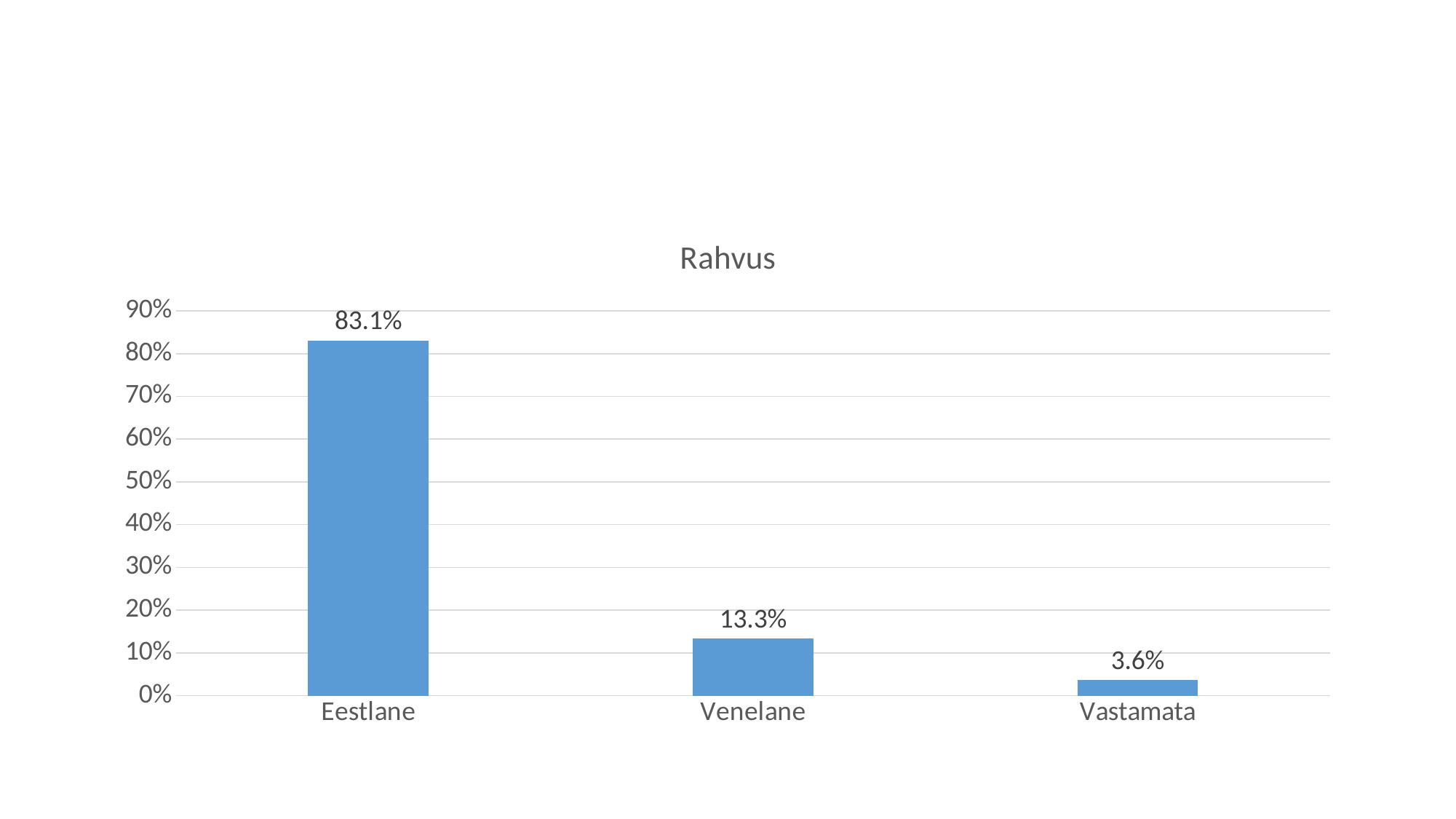
What is the value for Eestlane? 83.1% Is the value for Eestlane greater or less than 80%? greater What is the title of the chart? Rahvus How many categories are shown on the chart? 3 What is the difference between the values for Venelane and Vastamata? 9.7% What is the value for Vastamata? 3.6% What is the value for Venelane? 13.3% What kind of chart is shown on the slide? bar chart Which is larger, the value for Venelane or the value for Vastamata? Venelane Which category has the lowest value? Vastamata Which category has the highest value? Eestlane What is the difference between the values for Eestlane and Venelane? 69.8%